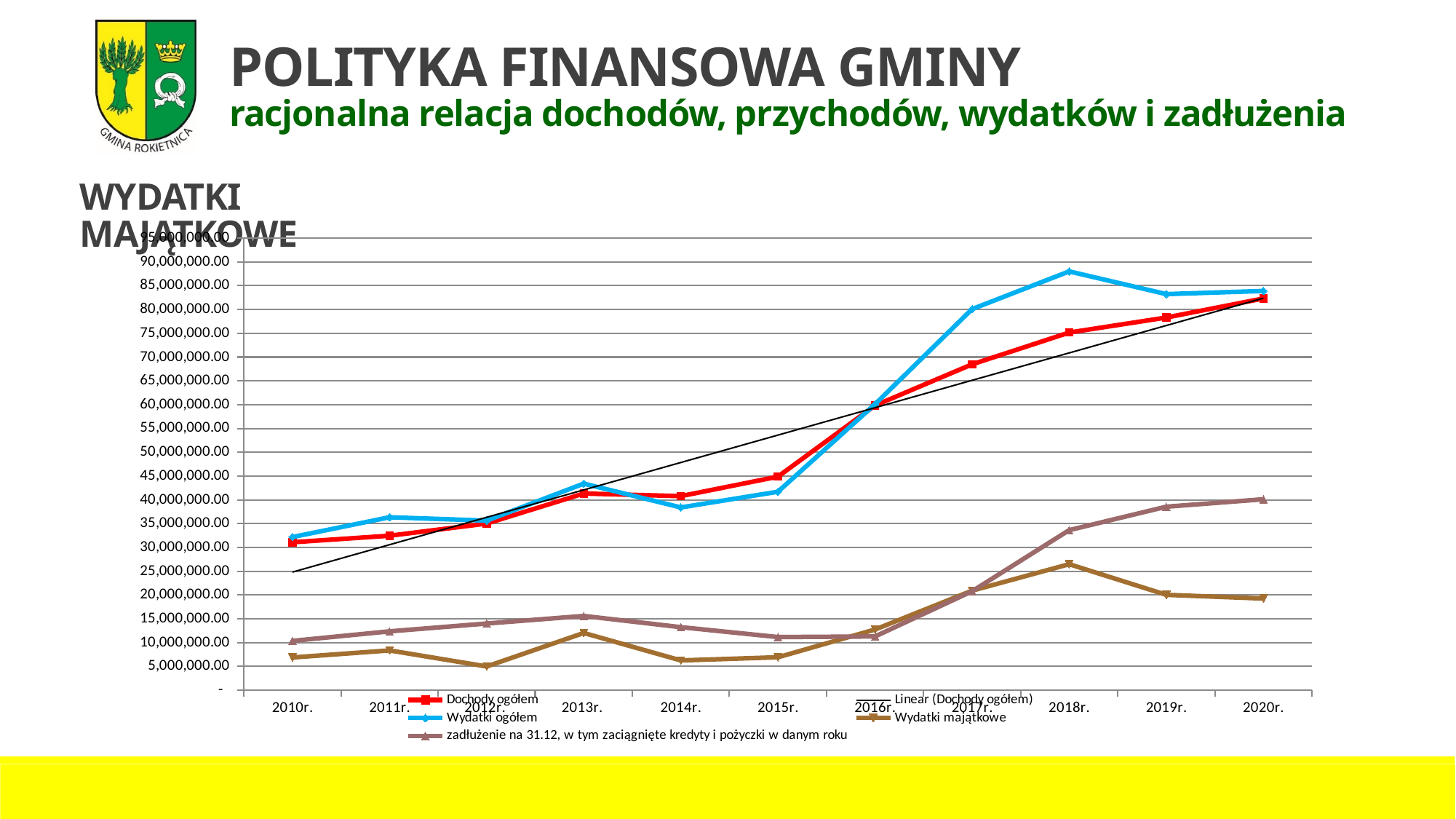
In which year is the Wydatki majątkowe series at its lowest? 2012r. How many years are shown along the x axis of the chart? 11 Is the value of zadłużenie na 31.12 in 2020r. greater or less than 35,000,000.00? greater In which year does the Wydatki ogółem series reach its highest value? 2018r. In 2014r., which is larger: Dochody ogółem or Wydatki ogółem? Dochody ogółem Is the value of Dochody ogółem in 2010r. greater or less than 35,000,000.00? less In which year does the zadłużenie na 31.12 series reach its highest value? 2020r. Does the Dochody ogółem series generally rise or fall from 2010r. to 2020r.? rise What kind of chart is shown on the slide? line chart In 2018r., which is larger: Wydatki ogółem or Dochody ogółem? Wydatki ogółem How many series does the chart legend list? 5 Is the value of Wydatki ogółem in 2018r. greater or less than 85,000,000.00? greater